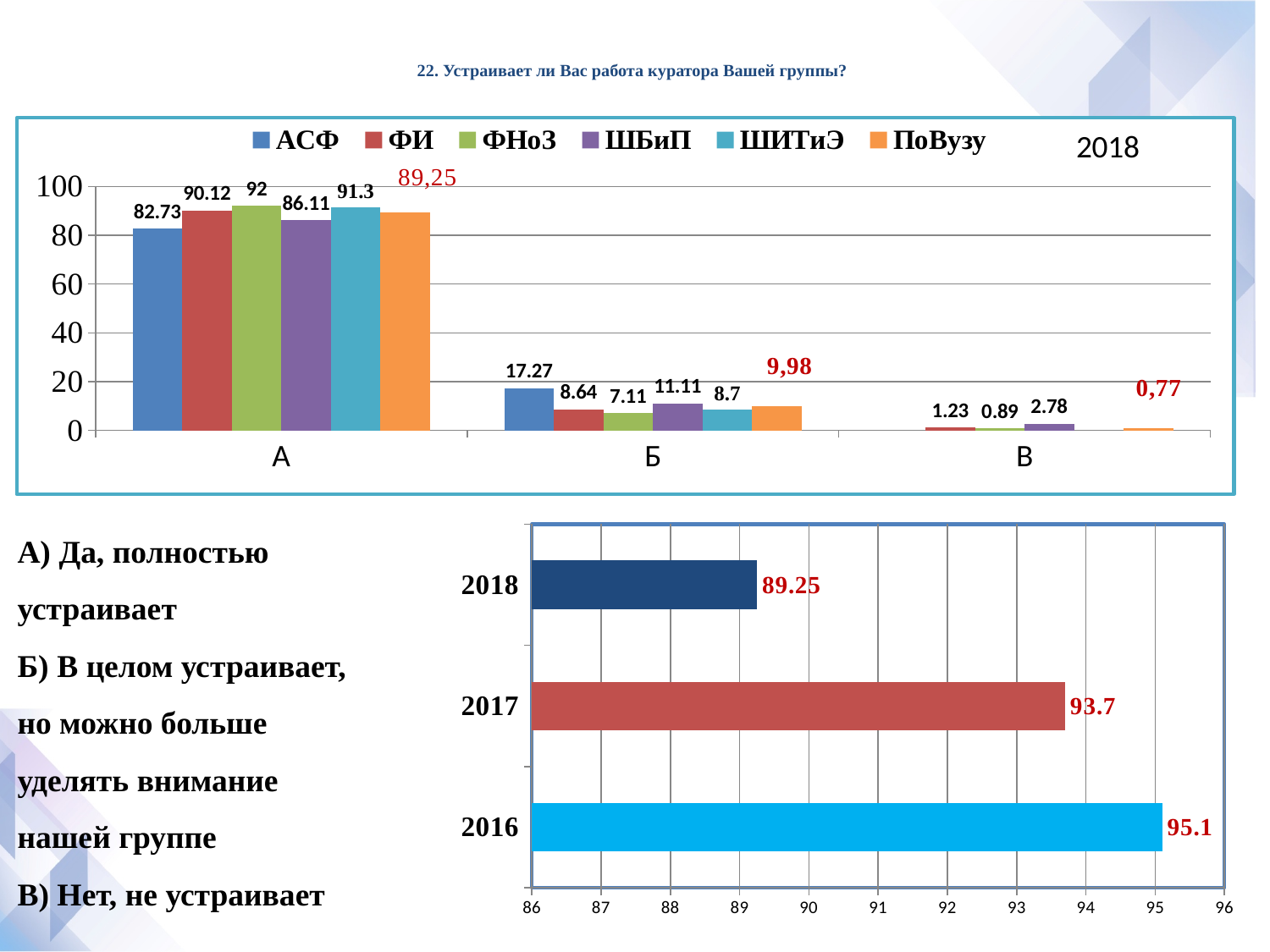
In the bottom chart, what is the value for 2017? 93.7 In the bottom chart, which year has the highest value? 2016 In the top chart (2018), what is the value for ФНоЗ in category А? 92 In the top chart (2018), which series has the highest value in category А? ФНоЗ In the top chart (2018), what is the difference between ФИ and АСФ in category А? 7.39 In the top chart (2018), how many categories are shown on the x axis? 3 In the top chart (2018), which series has the lowest value in category Б? ФНоЗ In the top chart (2018), what is the value for ПоВузу in category В? 0,77 What kind of chart is the bottom chart? Bar chart In the top chart (2018), which is larger in category Б: ШБиП or ШИТиЭ? ШБиП In the top chart (2018), what is the value for АСФ in category Б? 17.27 In the top chart (2018), how many series does the legend list? 6